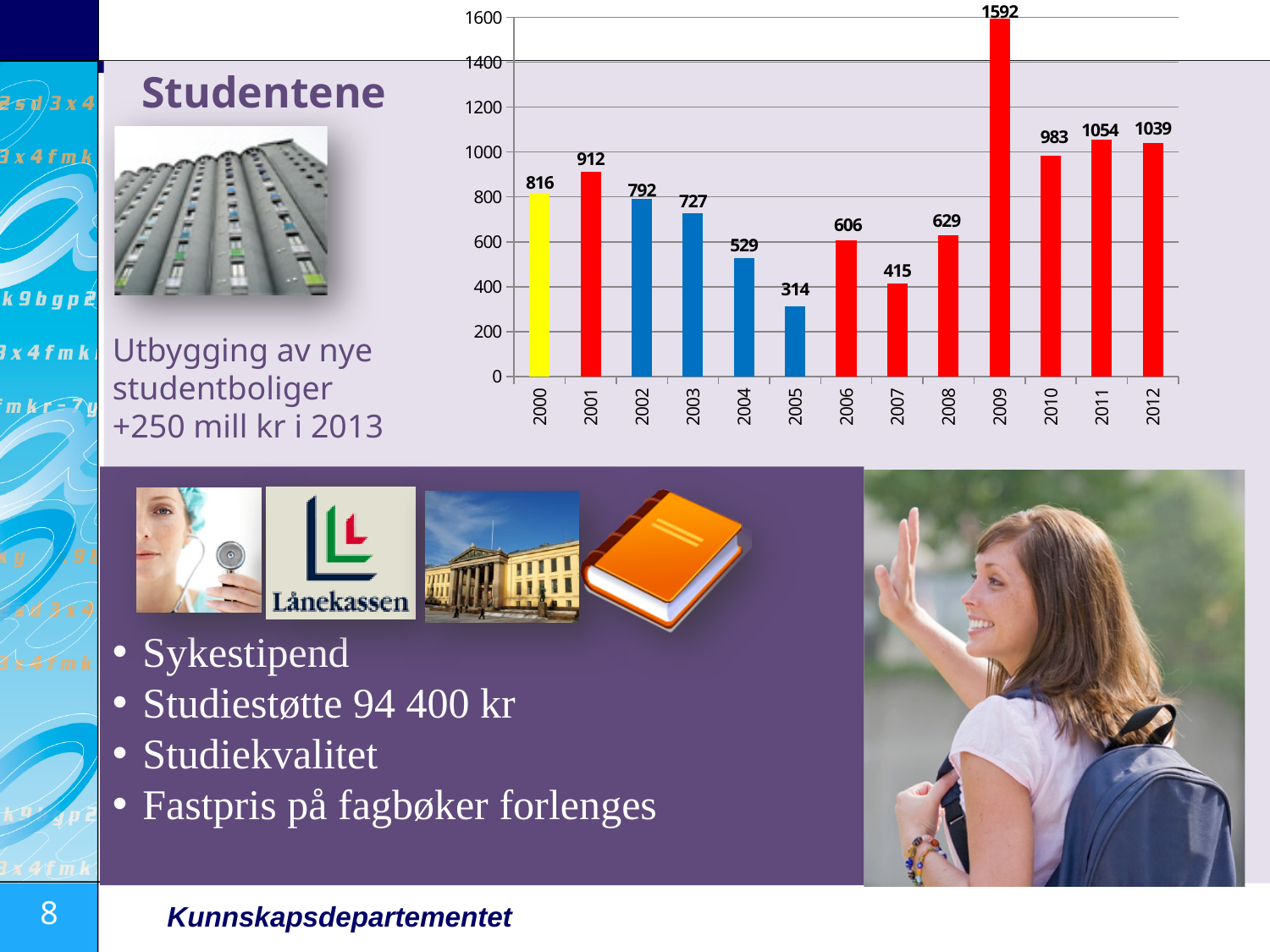
How many years are shown on the x axis? 13 Which is larger, the value for 2011 or the value for 2012? 2011 Which year has the highest value? 2009 Do the values rise or fall from 2001 to 2005? fall Which year has the lowest value? 2005 Is the value for 2007 greater or less than 600? less What is the value for 2000? 816 What kind of chart is shown? bar chart What colour is the bar for 2000? yellow What is the value for 2009? 1592 What is the value for 2005? 314 What is the difference between the values for 2009 and 2010? 609